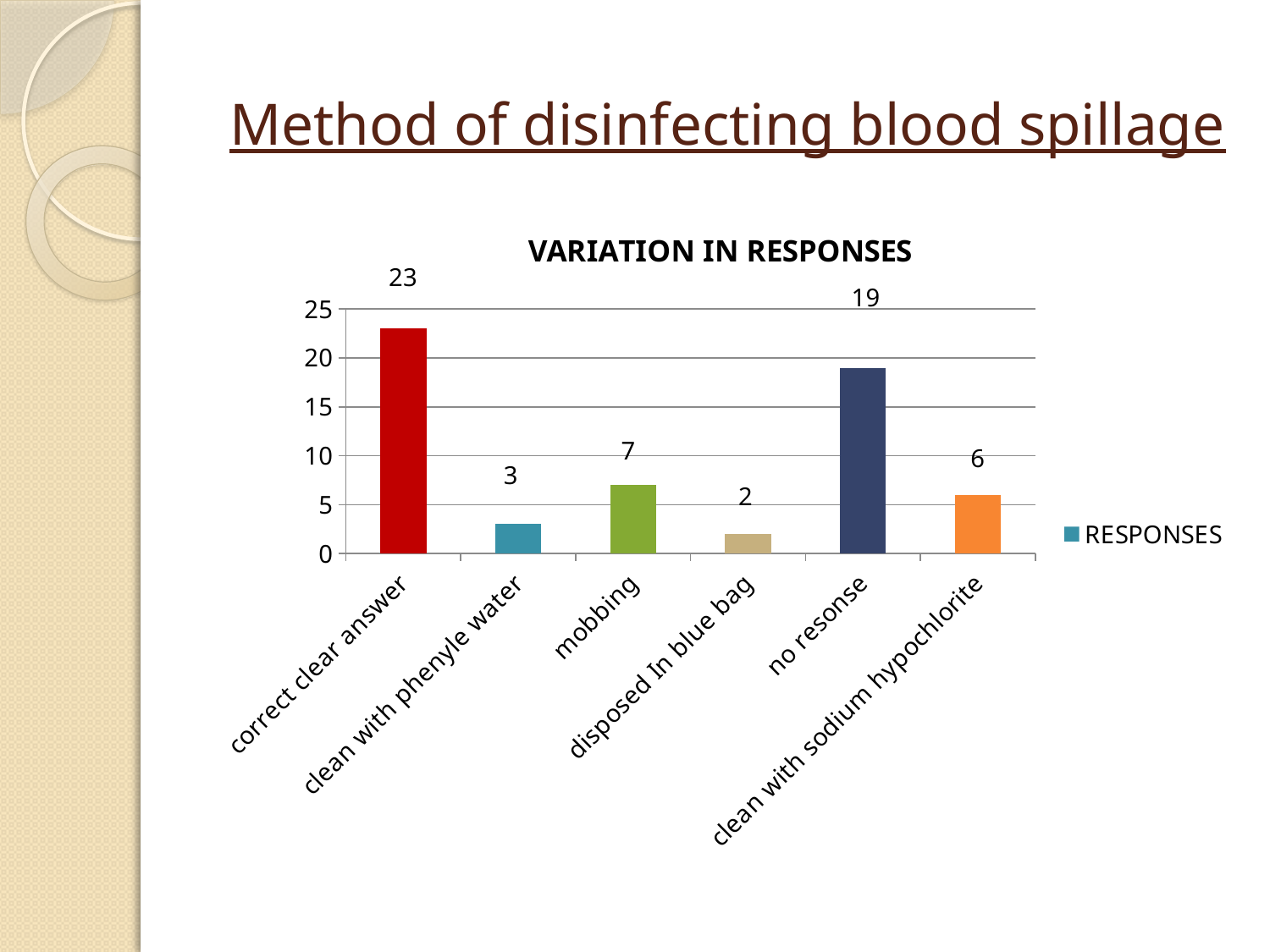
Is the value for "no resonse" greater or less than 15? greater What is the title of the chart? VARIATION IN RESPONSES How many categories are shown on the x axis? 6 What kind of chart is shown on the slide? bar chart How many series does the legend list? 1 What is the difference between the values for "correct clear answer" and "no resonse"? 4 What is the value for "correct clear answer"? 23 Which category has the highest value? correct clear answer Which is larger, the value for "mobbing" or the value for "clean with sodium hypochlorite"? mobbing Which category has the lowest value? disposed In blue bag What is the value for "clean with sodium hypochlorite"? 6 What is the value for "no resonse"? 19